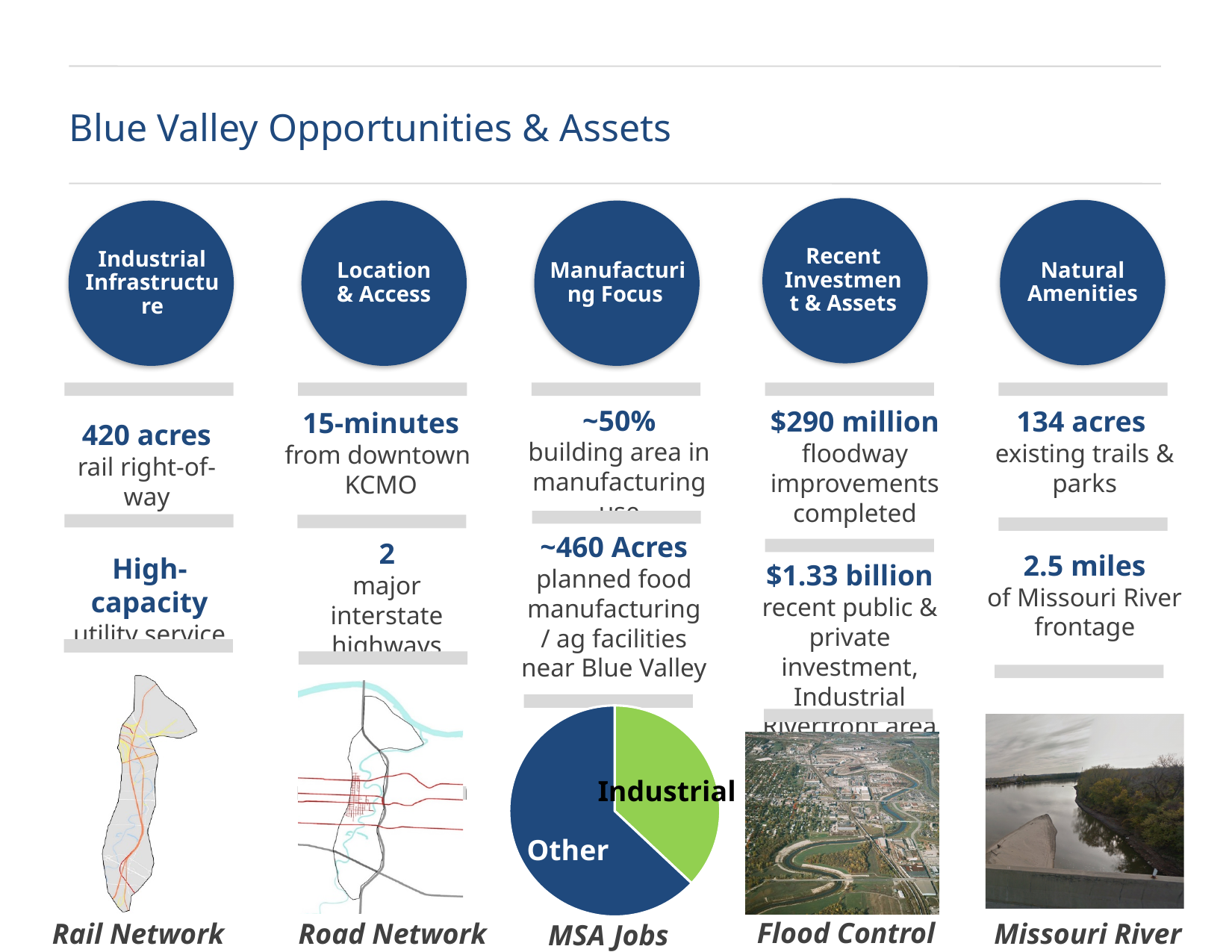
Which slice of the MSA Jobs pie chart is the smallest? Industrial In the MSA Jobs pie chart, which is larger: the Industrial slice or the Other slice? Other What colour is the Industrial slice in the MSA Jobs pie chart? green What are the two slice labels in the MSA Jobs pie chart? Industrial and Other How many slices does the MSA Jobs pie chart have? 2 What kind of chart is shown under the Manufacturing Focus column, captioned MSA Jobs? pie chart Which slice of the MSA Jobs pie chart is the largest? Other